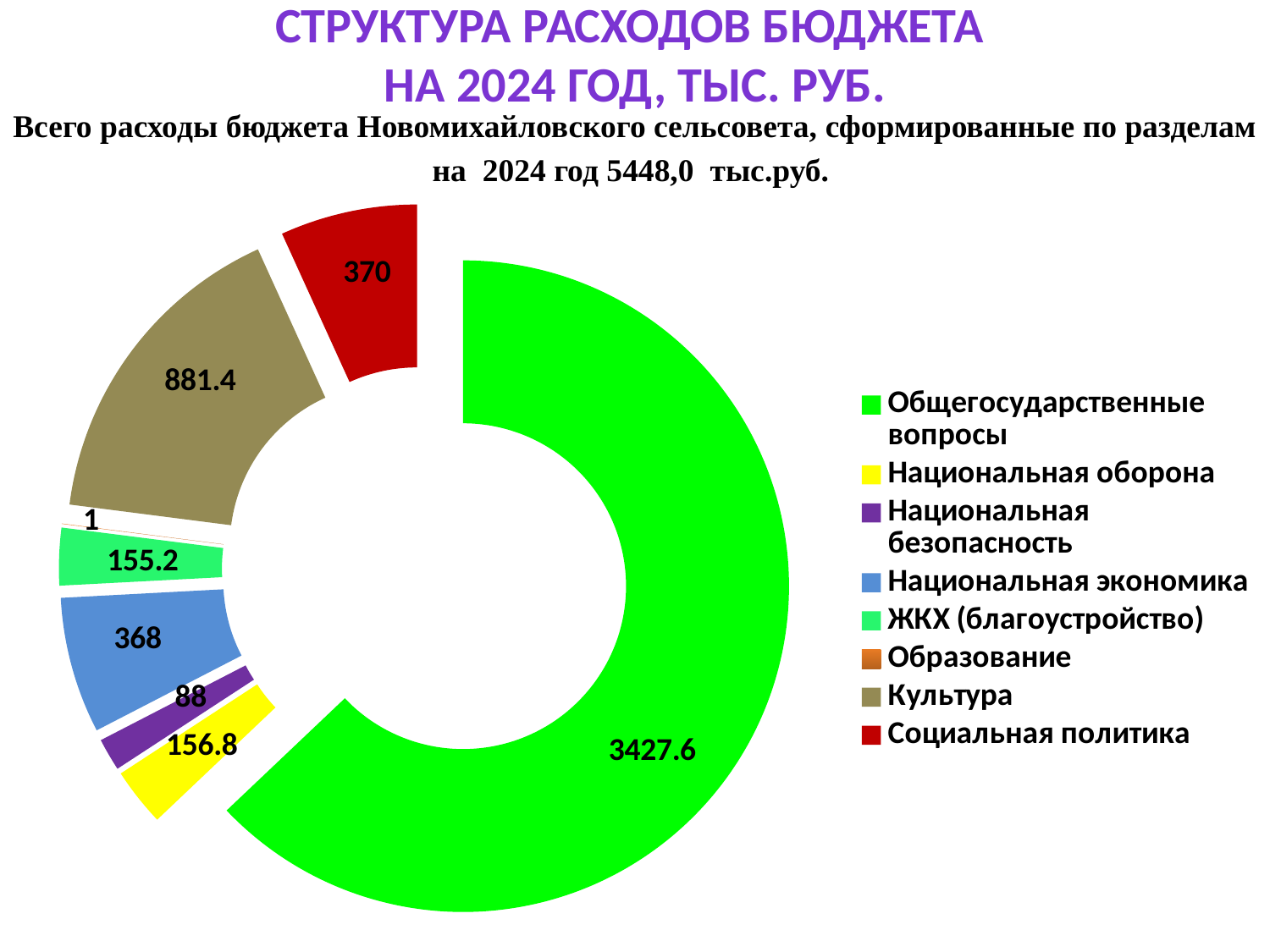
What is the value for Образование? 1 What is the value for Национальная экономика? 368 What is the difference between the values for Национальная оборона and ЖКХ (благоустройство)? 1.6 How many categories does the chart show? 8 What colour is the slice for Национальная оборона? yellow What is the difference between the values for Культура and Социальная политика? 511.4 Which category has the lowest value? Образование What is the value for Культура? 881.4 What kind of chart is shown on the slide? doughnut chart Which category has the highest value? Общегосударственные вопросы What is the value for Социальная политика? 370 Which is larger, the value for Культура or the value for Социальная политика? Культура